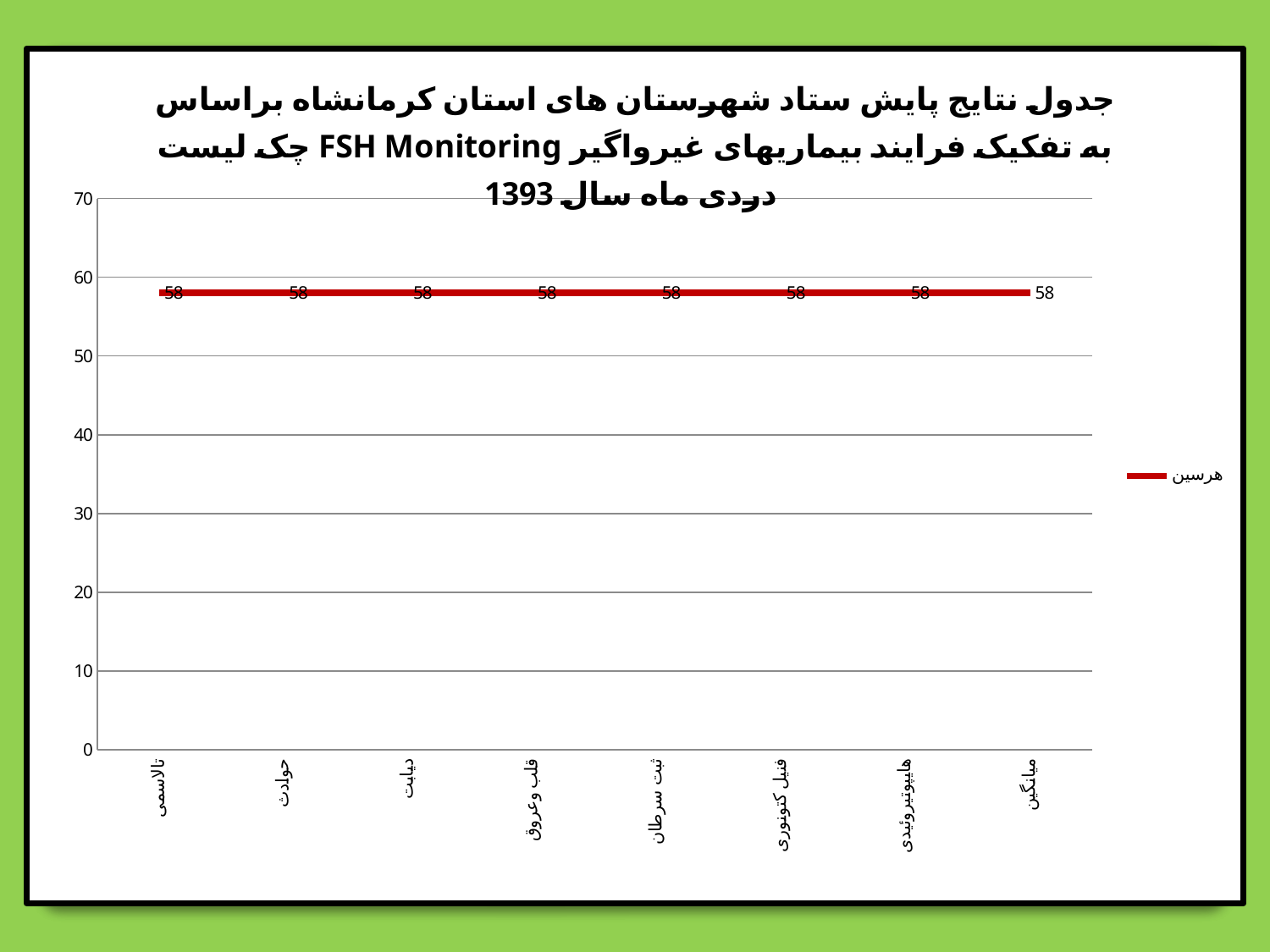
What is the difference between the values for ثبت سرطان and فنیل کتونوری? 0 What is the value for میانگین? 58 What is the name of the series shown in the legend? هرسین How many categories are shown on the x axis? 8 What is the value for دیابت? 58 What kind of chart is this? line chart Do the values rise, fall, or stay flat across the categories? stay flat What colour is the plotted line? red How many series does the legend list? 1 What is the value for تالاسمی? 58 Is the value for حوادث greater or less than 50? greater What is the value for هایپوتیروئیدی? 58